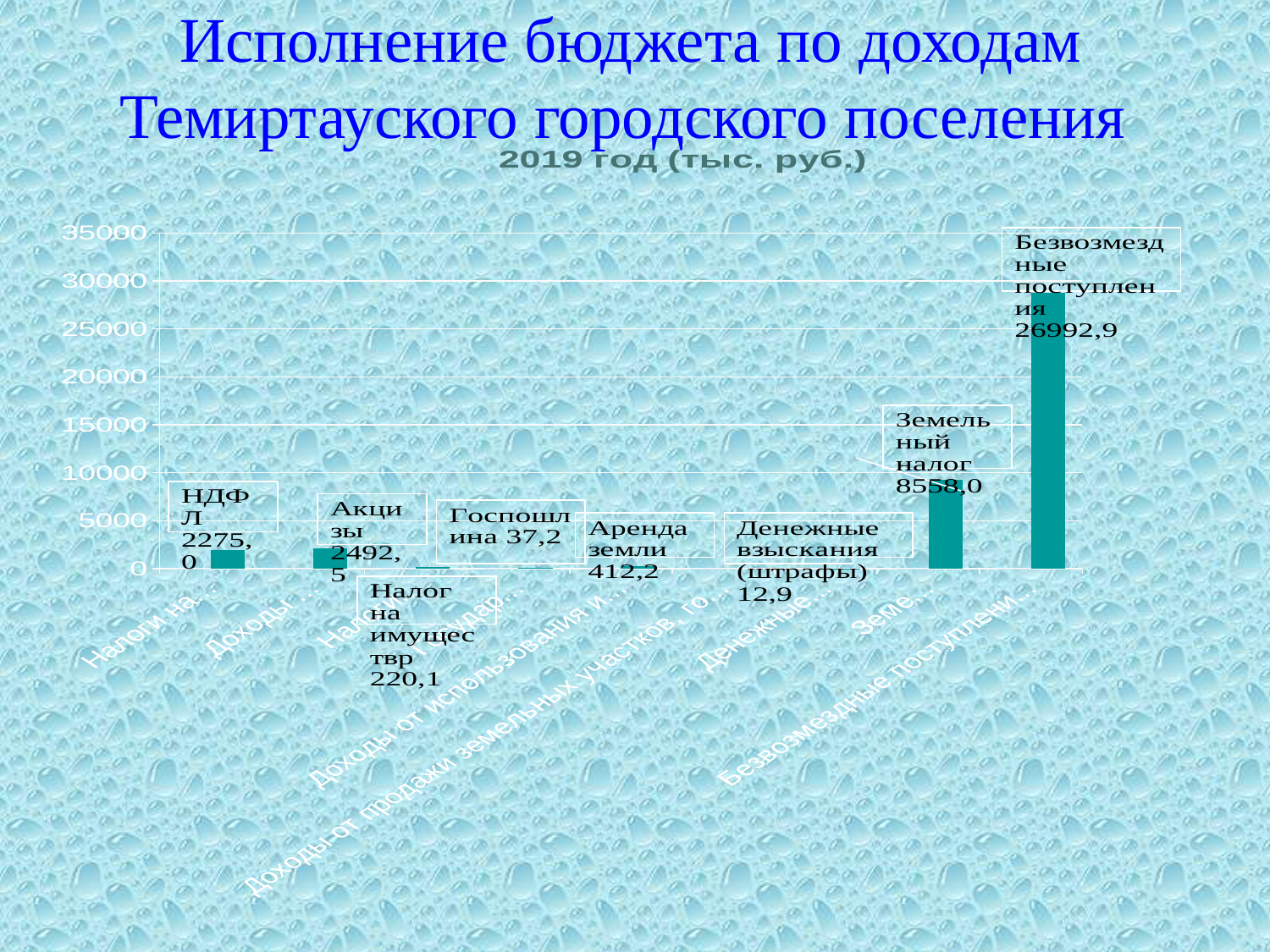
What kind of chart is shown on the slide? bar chart Is the value for Земельный налог greater or less than 5000? greater What is the value for НДФЛ? 2275,0 How many categories are shown in the chart? 9 What is the value for Акцизы? 2492,5 What is the value for Земельный налог? 8558,0 What is the difference between Безвозмездные поступления and Земельный налог? 18434,9 What is the value for Госпошлина? 37,2 What is the value for Безвозмездные поступления? 26992,9 Which is larger, Акцизы or НДФЛ? Акцизы Which category has the highest value? Безвозмездные поступления